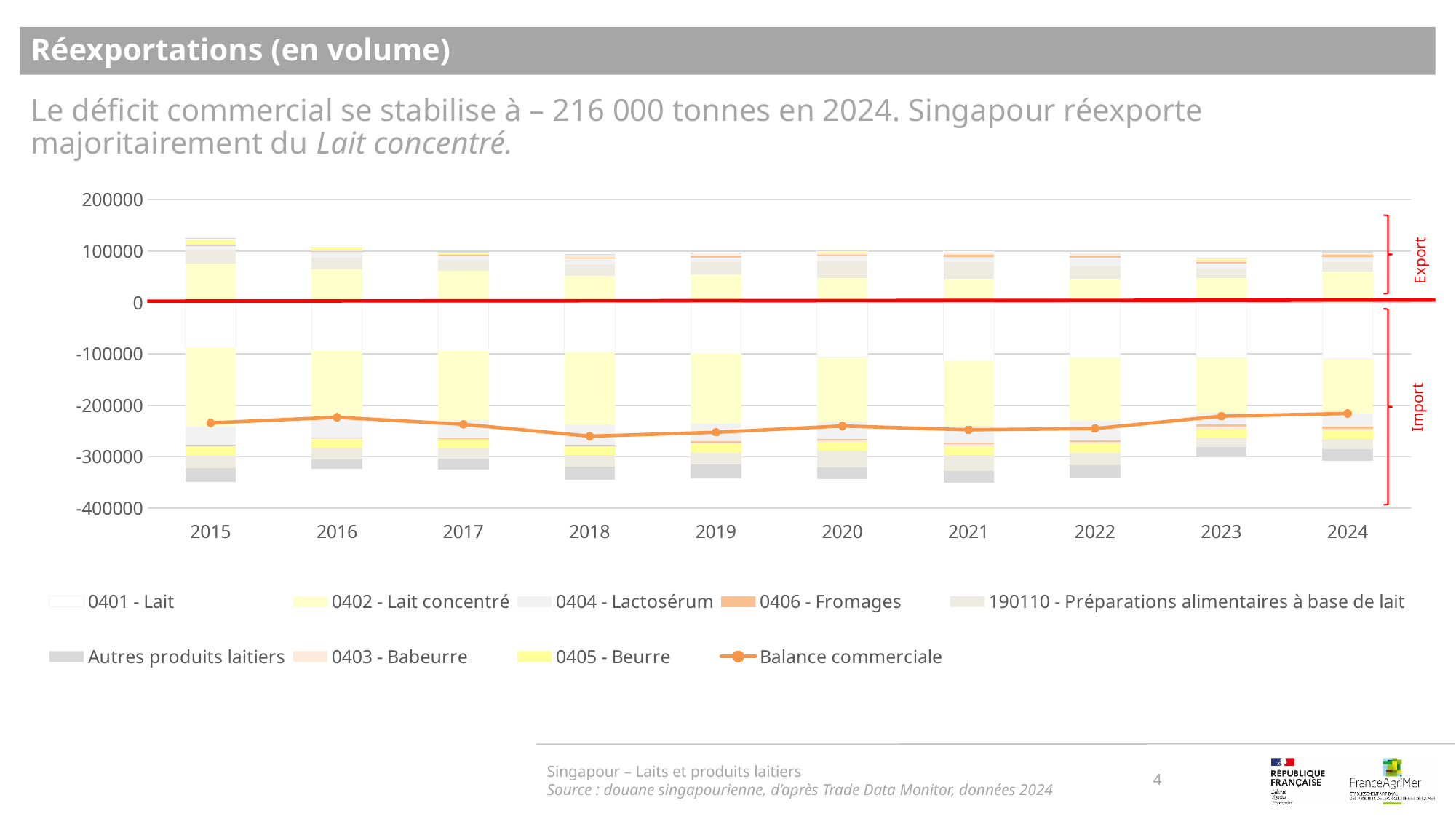
How many series does the chart legend list? 9 Is the total export stack for 2015 greater or less than 100000? greater Which year has the larger total export stack, 2015 or 2023? 2015 What kind of chart is shown on the slide? Stacked bar chart with a line Which series in the legend is plotted as a line with markers? Balance commerciale Does the 'Balance commerciale' line rise or fall from 2018 to 2024? Rise How many years are shown on the x axis of the chart? 10 What colour is used for the series '0402 - Lait concentré'? Yellow Is the total export stack for 2023 greater or less than 100000? less Is the value of 'Balance commerciale' in 2024 greater or less than -300000? greater In which year is the 'Balance commerciale' line at its lowest point? 2018